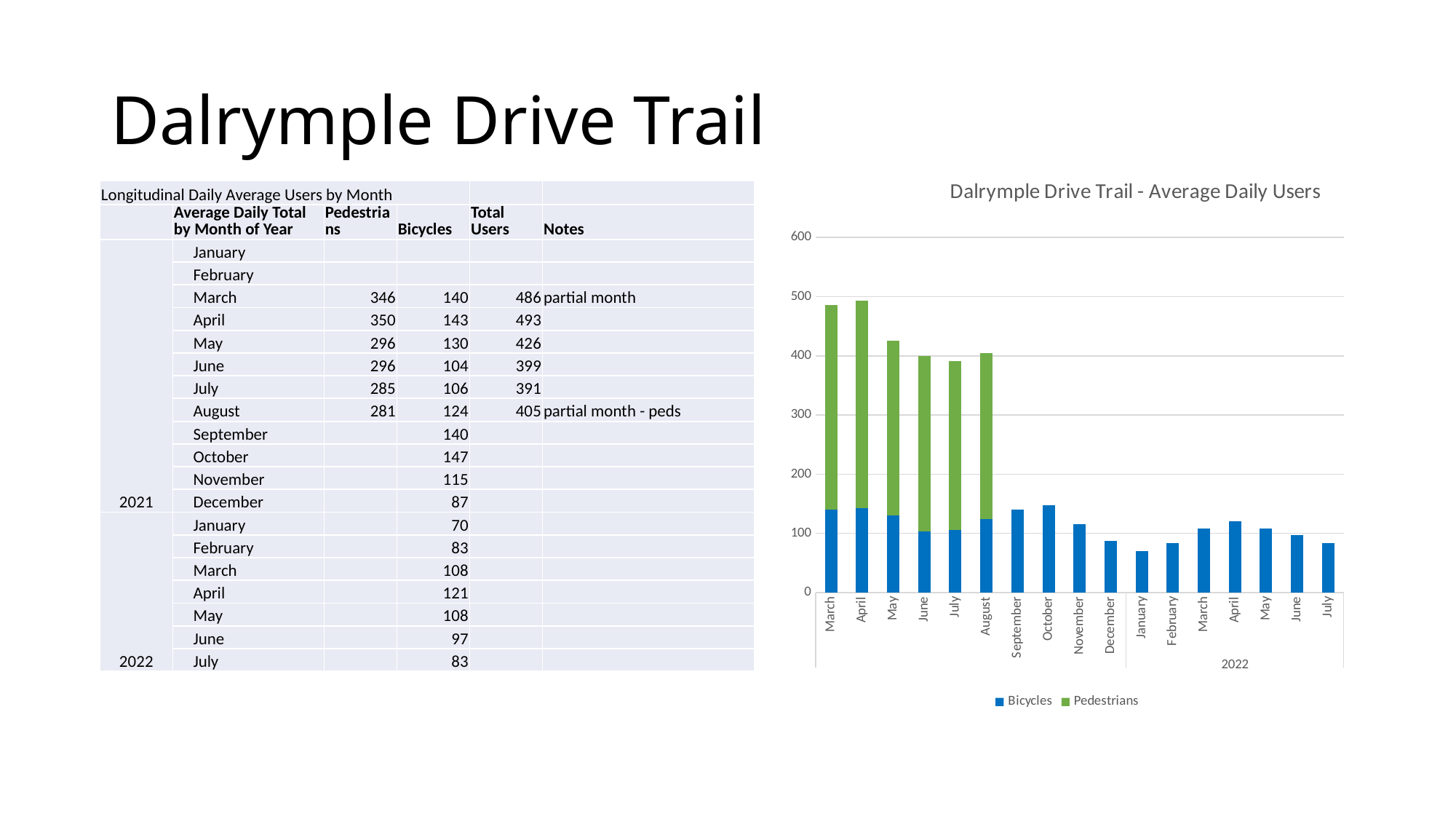
In May 2021, which is larger, the Pedestrians value or the Bicycles value? Pedestrians Is the total stacked bar for April 2021 greater or less than 400? greater What are the two series named in the chart legend? Bicycles and Pedestrians What kind of chart is shown on the slide? bar chart How many series does the chart legend list? 2 What is the total of the stacked bar for March 2021? 486 What is the difference between the Pedestrians values for April 2021 and March 2021? 4 How many months are plotted along the x axis of the chart? 17 What is the Bicycles value for October 2021? 147 Which month has the lowest Bicycles value in the chart? January 2022 What is the title of the chart? Dalrymple Drive Trail - Average Daily Users Is the Bicycles value for January 2022 greater or less than 100? less